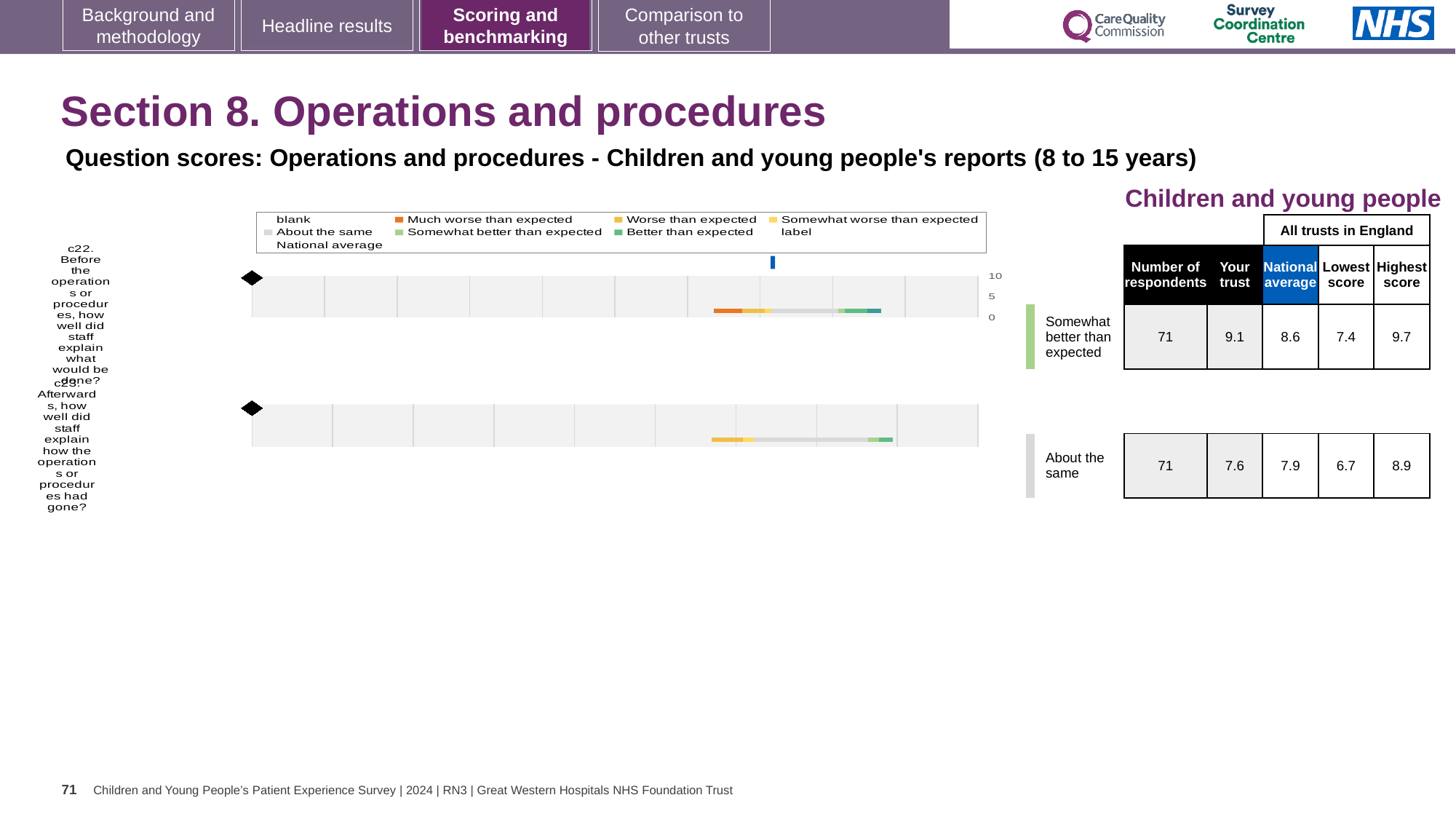
What is the difference between the trust's score and the national average for question c22? 0.5 What is the highest score across all trusts in England for question c22? 9.7 What is the lowest score across all trusts in England for question c23? 6.7 How many entries does the chart legend list? 9 Which legend entry is shown in orange in the chart? Much worse than expected How many questions (bars) are plotted in the chart? 2 What kind of chart is used to show the question scores for operations and procedures? bar chart What benchmark category is the trust's score for question c23 placed in? About the same What is the 'Your trust' score for question c22 (how well staff explained what would be done before the operation)? 9.1 What is the national average score for question c23 (how well staff explained how the operation had gone)? 7.9 How many respondents answered question c22? 71 Which question has the higher 'Your trust' score, c22 or c23? c22